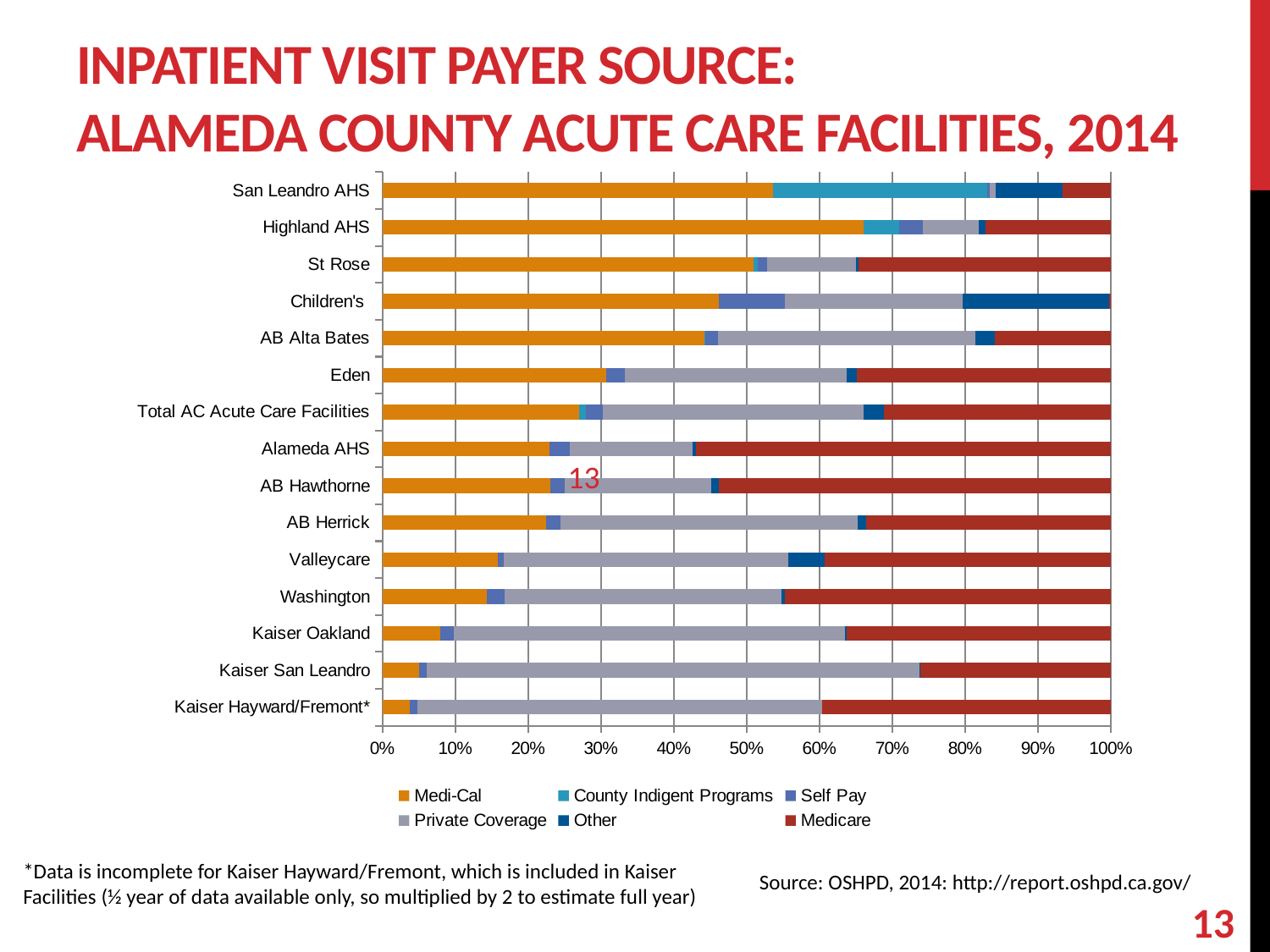
Which facility has the largest Medi-Cal share? Highland AHS Which payer source is shown in orange in the legend? Medi-Cal What kind of chart is shown on the slide? Stacked bar chart Is the Medi-Cal share for Kaiser Hayward/Fremont* greater or less than 10%? less How many payer sources does the legend list? 6 Is the Medi-Cal share for San Leandro AHS greater or less than 50%? greater Which has the larger Private Coverage share, Kaiser San Leandro or Kaiser Hayward/Fremont*? Kaiser San Leandro Which facility has the largest County Indigent Programs share? San Leandro AHS Is the Medi-Cal share for Highland AHS greater or less than 60%? greater How many facilities (categories) are listed on the chart? 15 Which has the larger Medi-Cal share, Eden or Alameda AHS? Eden